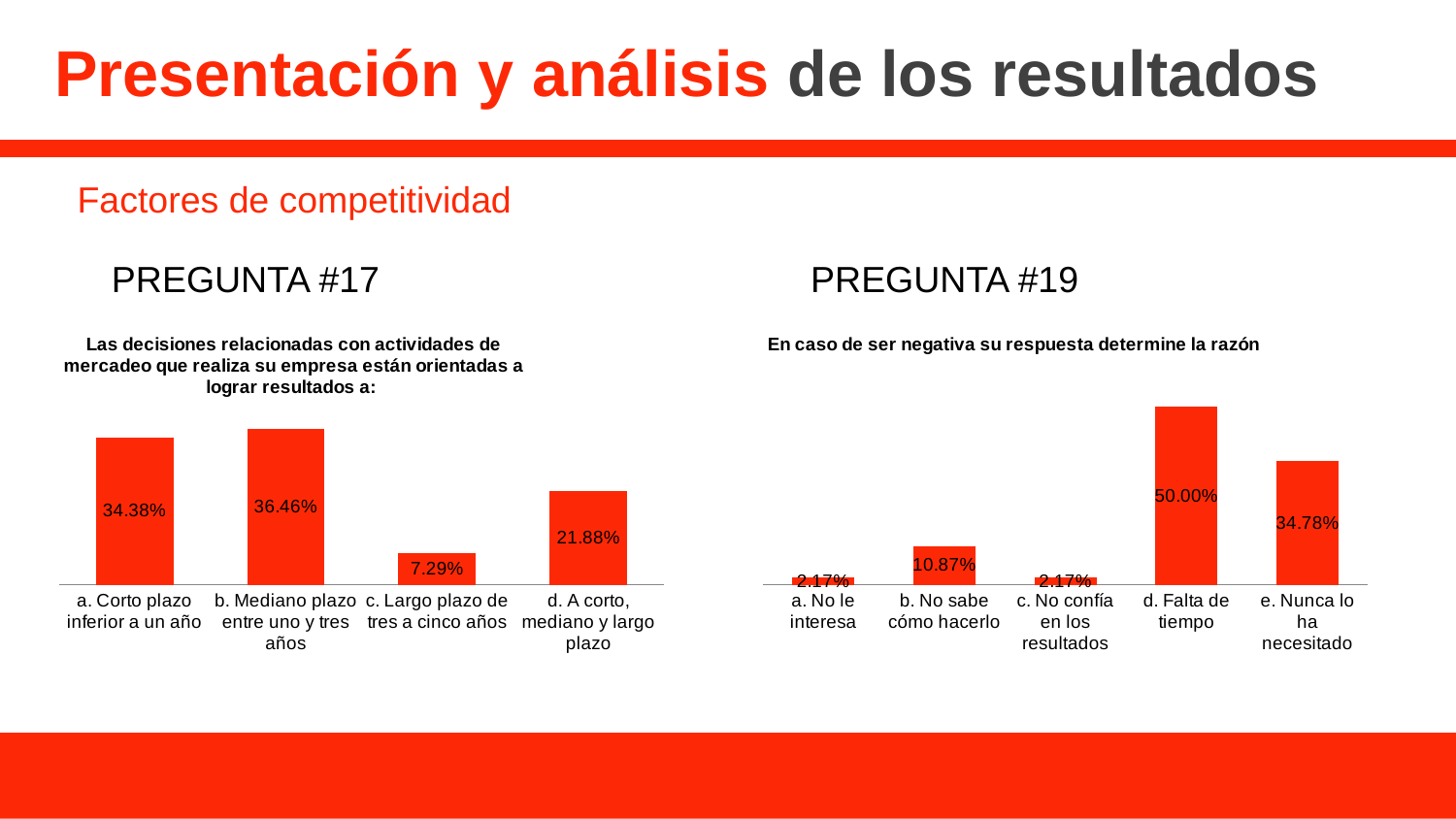
In the Pregunta #17 chart, what is the value for 'b. Mediano plazo entre uno y tres años'? 36.46% What type of chart is used for Pregunta #17? Bar chart In the Pregunta #19 chart, what is the value for 'd. Falta de tiempo'? 50.00% In the Pregunta #17 chart, what is the value for 'c. Largo plazo de tres a cinco años'? 7.29% In the Pregunta #17 chart, how many categories are shown? 4 In the Pregunta #19 chart, what is the difference between 'd. Falta de tiempo' and 'e. Nunca lo ha necesitado'? 15.22% In the Pregunta #19 chart, what is the value for 'b. No sabe cómo hacerlo'? 10.87% In the Pregunta #17 chart, what is the difference between 'a. Corto plazo inferior a un año' and 'd. A corto, mediano y largo plazo'? 12.50% In the Pregunta #19 chart, which category has the highest value? d. Falta de tiempo In the Pregunta #17 chart, which category has the lowest value? c. Largo plazo de tres a cinco años In the Pregunta #19 chart, how many categories are shown? 5 In the Pregunta #19 chart, which is larger: 'e. Nunca lo ha necesitado' or 'b. No sabe cómo hacerlo'? e. Nunca lo ha necesitado